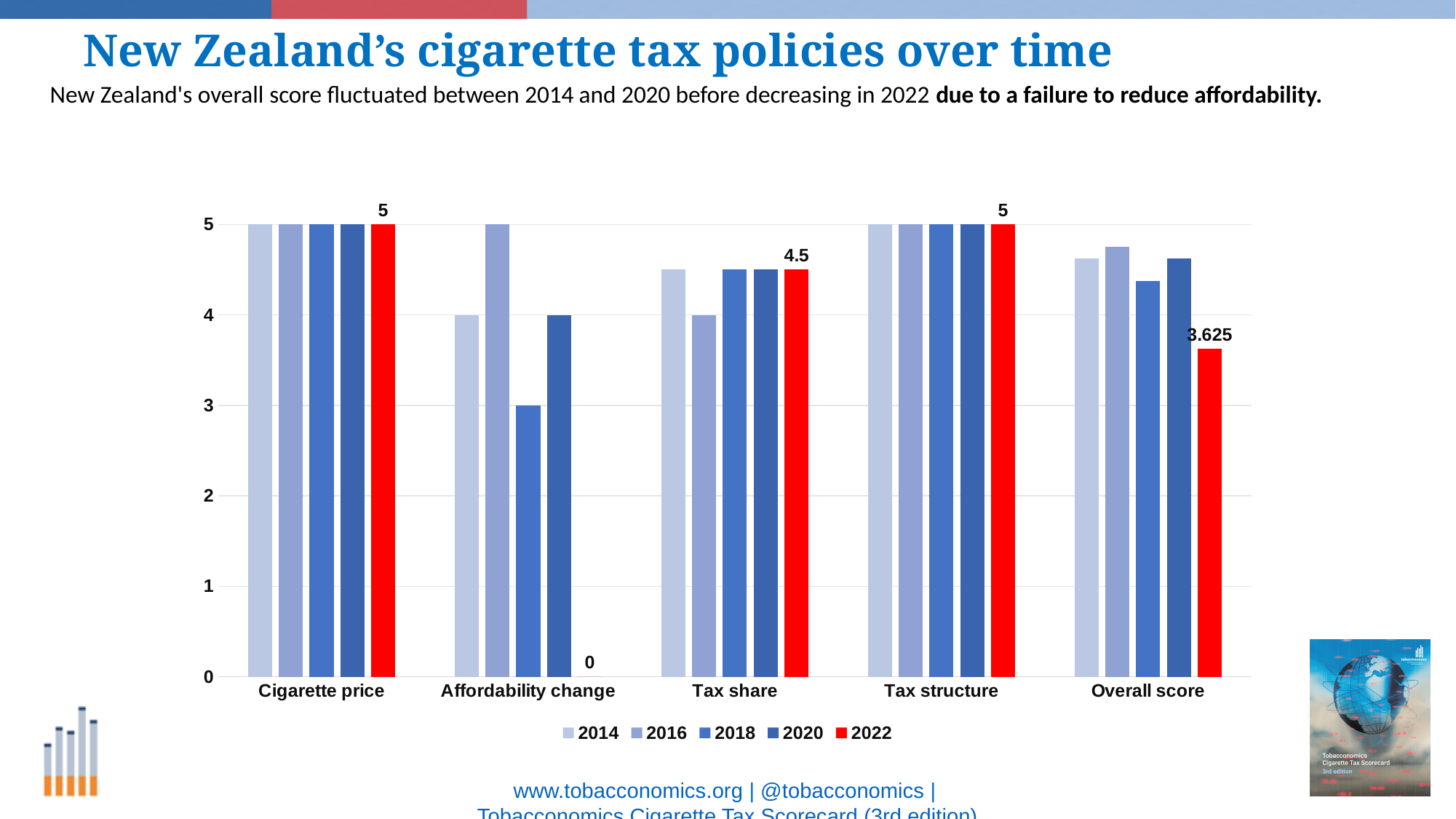
What is the difference between the 2022 values for Cigarette price and Overall score? 1.375 Which category has the lowest 2022 value? Affordability change How many series does the legend list? 5 What is the 2022 value for Overall score? 3.625 Is the 2018 value for Overall score greater or less than 4? greater What is the 2022 value for Tax share? 4.5 Which is larger, the 2022 value for Tax share or the 2022 value for Overall score? Tax share What is the 2022 value for Tax structure? 5 How many categories are shown on the x axis? 5 What kind of chart is shown on the slide? Bar chart What is the 2022 value for Affordability change? 0 Is the 2018 value for Affordability change greater or less than 4? less